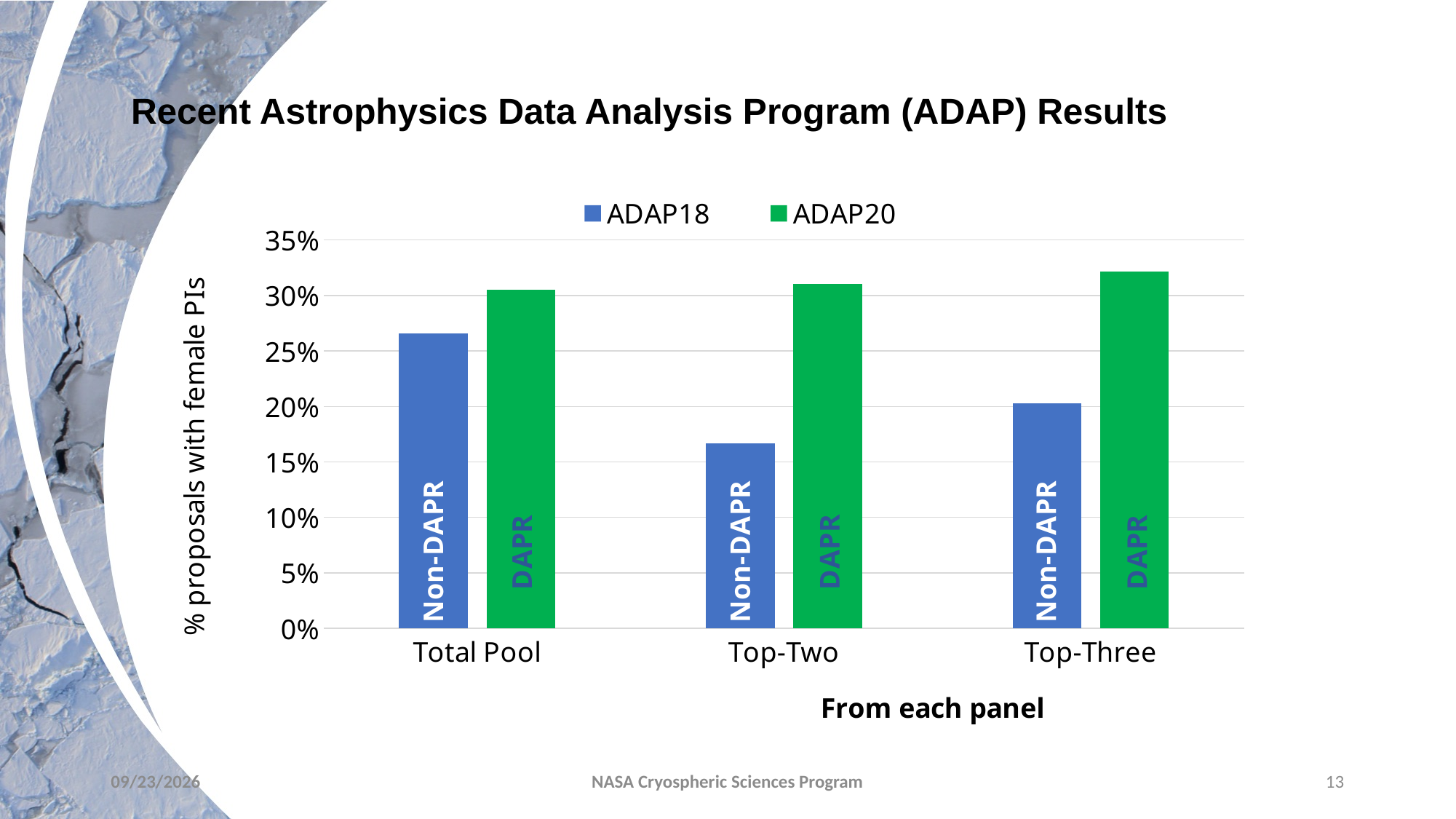
Is the ADAP18 value for Top-Two greater or less than 20%? less How many series does the legend list? 2 How many categories are shown on the x axis? 3 Which series is shown in green in the legend? ADAP20 What is the y-axis title of the chart? % proposals with female PIs What kind of chart is shown on the slide? bar chart Is the ADAP20 value for Top-Three greater or less than 30%? greater Which category has the lowest ADAP18 value? Top-Two Is the ADAP18 value for Total Pool greater or less than 25%? greater Which category has the highest ADAP18 value? Total Pool For Top-Two, which series has the larger value, ADAP18 or ADAP20? ADAP20